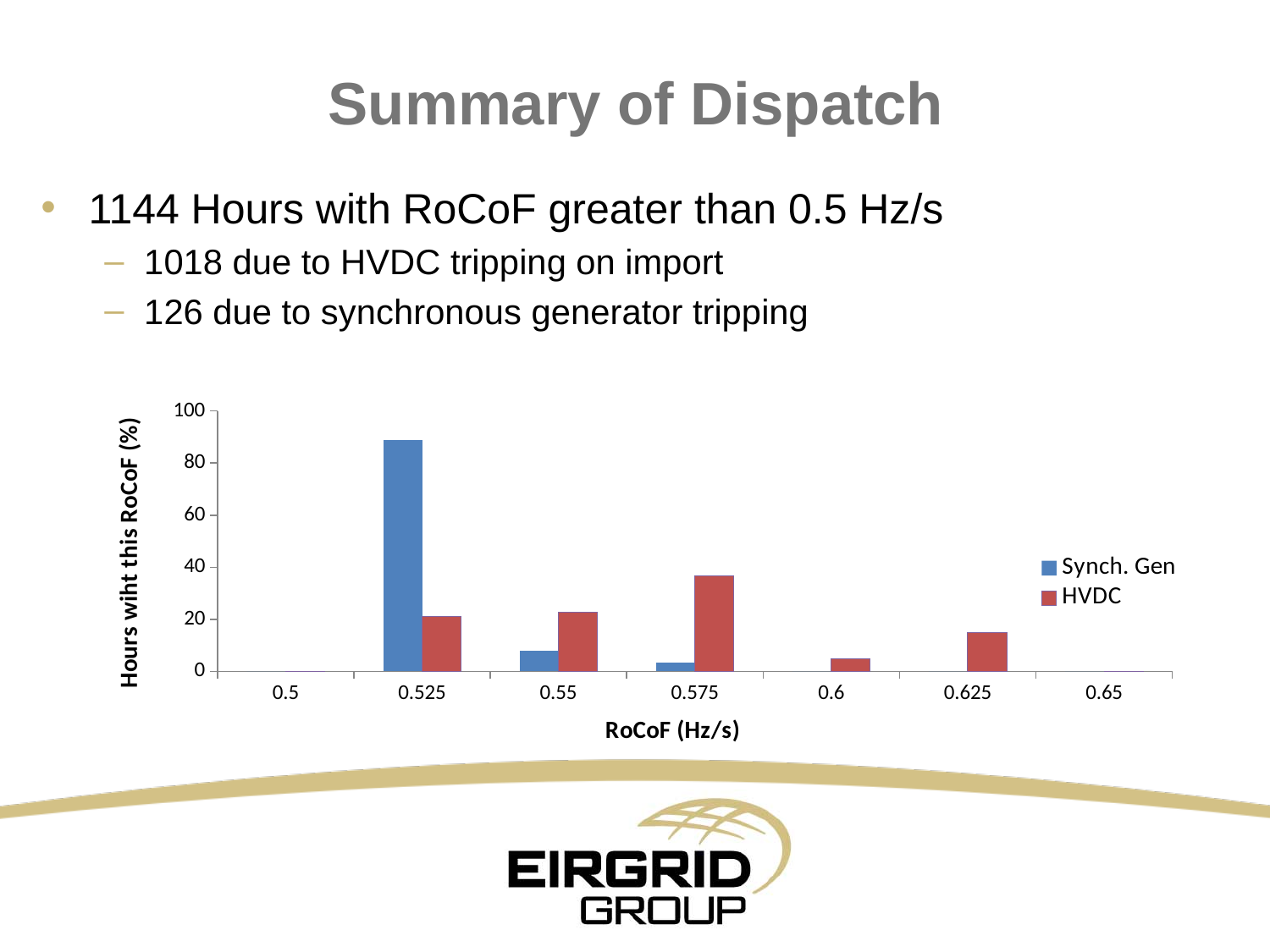
What is the title of the chart's x axis? RoCoF (Hz/s) At 0.525 Hz/s, which series has the larger value, Synch. Gen or HVDC? Synch. Gen At which RoCoF value is the Synch. Gen bar highest? 0.525 At which RoCoF value is the HVDC bar highest? 0.575 Is the Synch. Gen value at 0.525 Hz/s greater or less than 80? greater What kind of chart is shown on the slide? bar chart How many series does the chart legend list? 2 How many RoCoF categories are shown on the x axis of the chart? 7 Is the HVDC value at 0.575 Hz/s greater or less than 40? less At 0.55 Hz/s, which series has the larger value, Synch. Gen or HVDC? HVDC Is the HVDC value at 0.625 Hz/s greater or less than 20? less Which colour represents the HVDC series in the chart? red